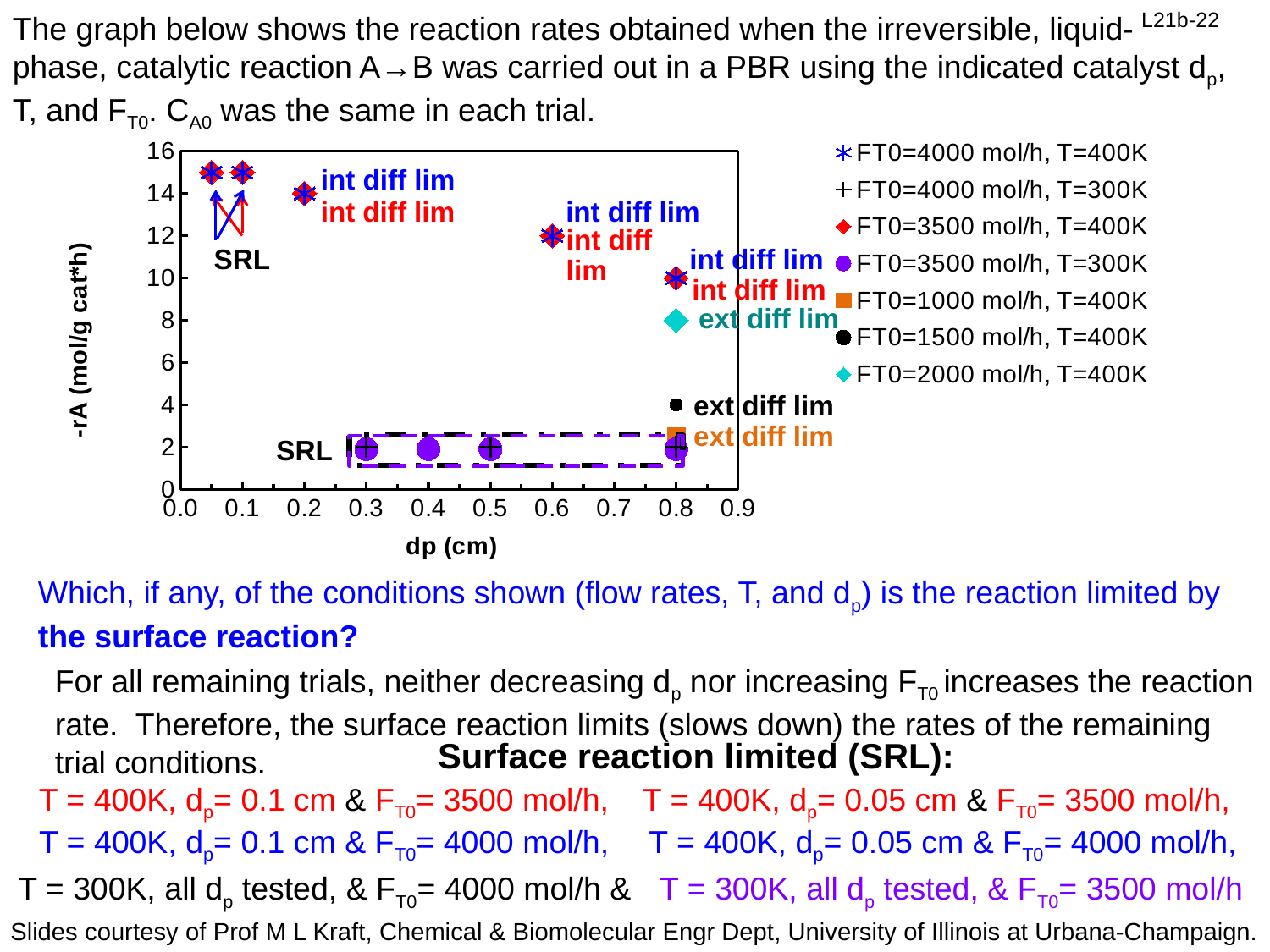
What is the reaction rate for FT0=1500 mol/h, T=400K at dp=0.8 cm? 4 Among the T=400K series at dp=0.8 cm, which flow rate gives the lowest reaction rate? FT0=1000 mol/h How many series does the chart legend list? 7 What is the reaction rate for FT0=4000 mol/h, T=400K at dp=0.6 cm? 12 What kind of chart is shown on the slide? scatter chart What is the label of the horizontal axis of the chart? dp (cm) Is the reaction rate for FT0=4000 mol/h, T=300K at dp=0.3 cm greater or less than 4? less For the FT0=4000 mol/h, T=400K series, does the reaction rate rise or fall as dp increases? falls Is the reaction rate for FT0=4000 mol/h, T=400K at dp=0.05 cm greater or less than 14? greater What is the label of the vertical axis of the chart? -rA (mol/g cat*h) What is the reaction rate for FT0=2000 mol/h, T=400K at dp=0.8 cm? 8 At dp=0.8 cm and T=400K, which gives the larger reaction rate: FT0=1500 mol/h or FT0=1000 mol/h? FT0=1500 mol/h